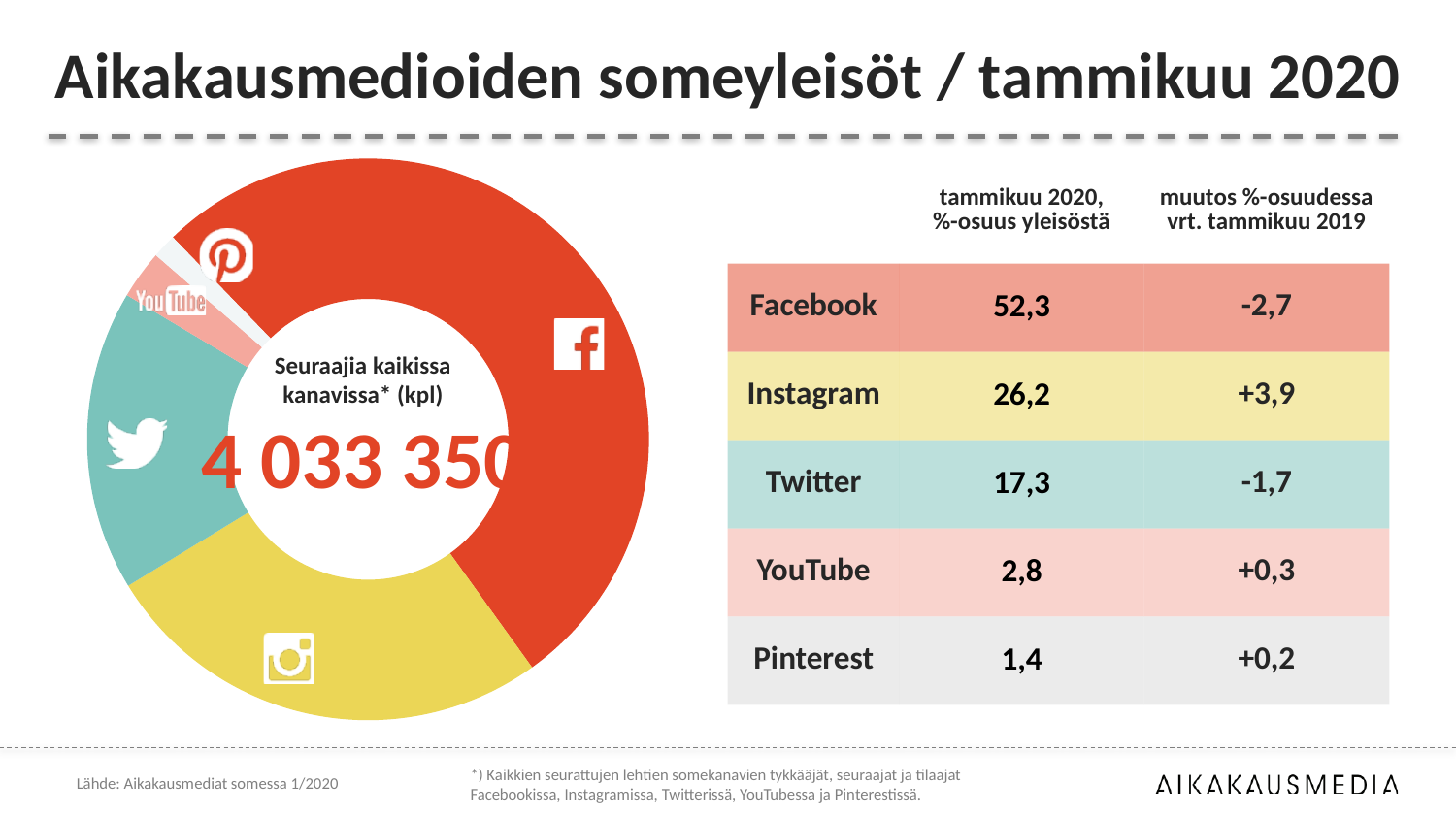
What is the difference in percentage share between Facebook and Instagram in January 2020? 26,1 Which channel has the largest slice in the donut chart? Facebook Which channel's slice is larger in the donut chart, Twitter or Instagram? Instagram According to the table, what is Facebook's share of the audience in January 2020? 52,3 What is the change in percentage share for Twitter compared with January 2019? -1,7 Which channel has the smallest slice in the donut chart? Pinterest What colour is the Twitter slice in the donut chart? Teal (turquoise) How many social media channels are shown as slices in the donut chart? 5 What total number of followers across all channels is printed in the centre of the donut chart? 4 033 350 Which channel had the largest increase in percentage share compared with January 2019? Instagram According to the table, what is Instagram's share of the audience in January 2020? 26,2 What kind of chart is shown on the left of the slide? Pie (donut) chart